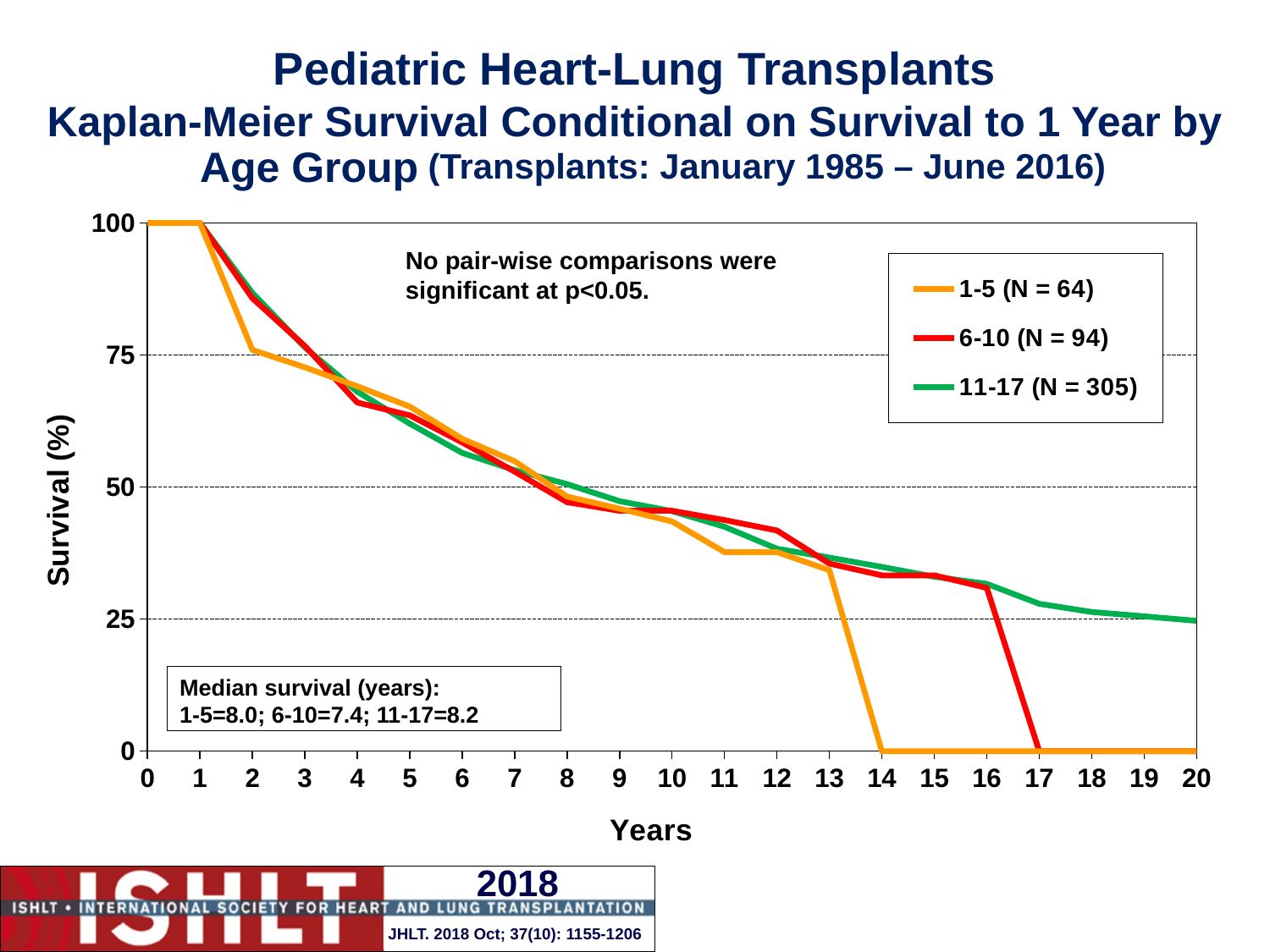
What is the difference in median survival (years) between the 11-17 and 6-10 age groups? 0.8 At 17 years, which age group has higher survival, 6-10 or 11-17? 11-17 Is the survival value for the 1-5 age group at 14 years greater or less than 25? less Which age group has the lowest median survival? 6-10 How many series does the legend list? 3 Do the survival curves rise or fall as years increase? fall Which age group has the highest median survival? 11-17 What is the median survival in years for the 1-5 age group? 8.0 What is the median survival in years for the 6-10 age group? 7.4 What kind of chart is shown on the slide? line chart What is the sample size (N) for the 11-17 age group? 305 Is the survival value for the 11-17 age group at 10 years greater or less than 50? less